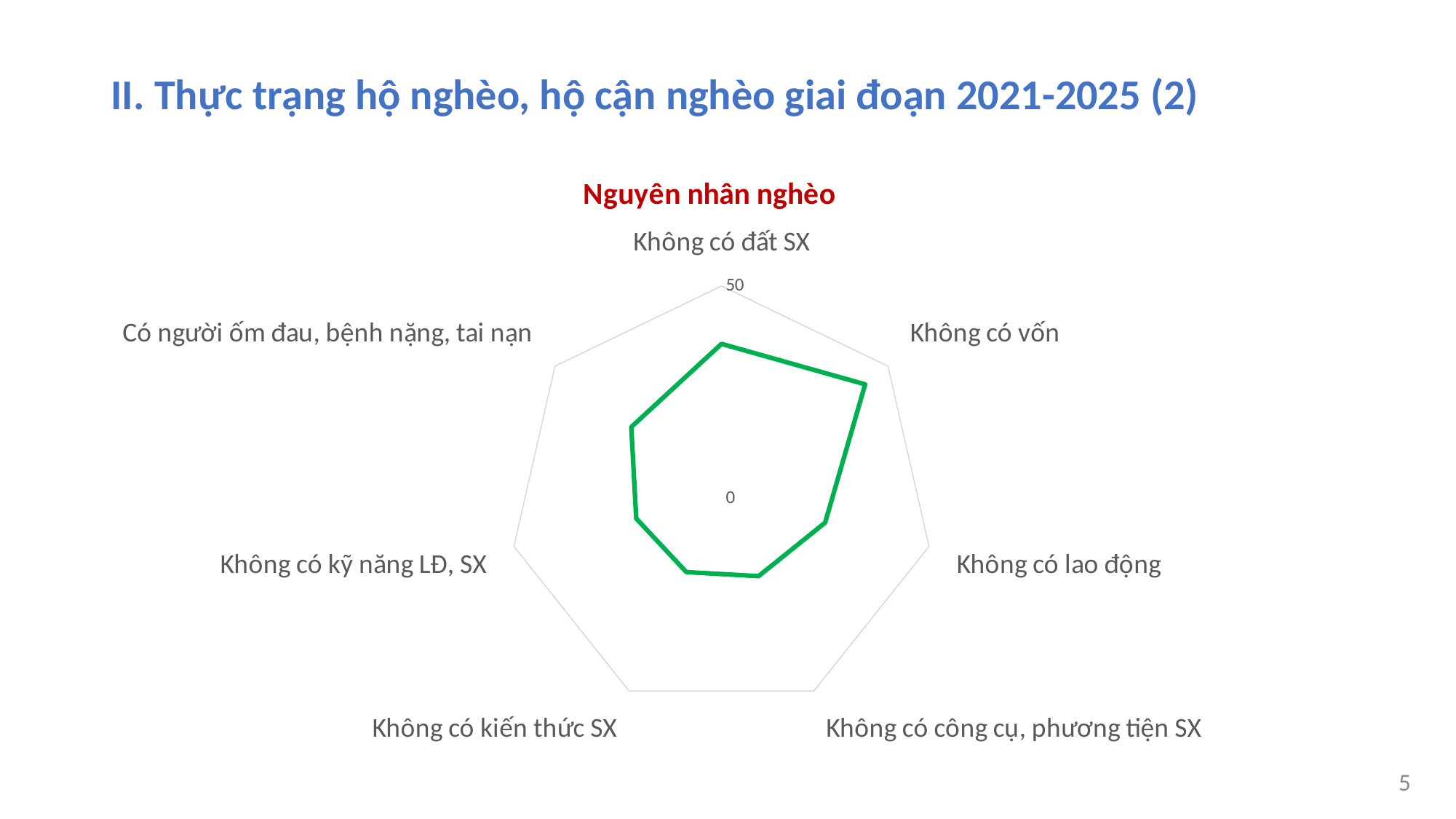
What kind of chart is shown on the slide? Radar chart Which is larger, the value for Không có đất SX or the value for Không có kiến thức SX? Không có đất SX Is the value for Không có vốn greater or less than 50? less What is the title of the chart? Nguyên nhân nghèo Which is larger, the value for Có người ốm đau, bệnh nặng, tai nạn or the value for Không có công cụ, phương tiện SX? Có người ốm đau, bệnh nặng, tai nạn Which category has the highest value on the radar chart? Không có vốn Which is larger, the value for Không có vốn or the value for Không có kỹ năng LĐ, SX? Không có vốn How many categories (axes) does the radar chart have? 7 What is the maximum value shown on the radar chart's axis scale? 50 Is the value for Không có đất SX greater or less than 50? less